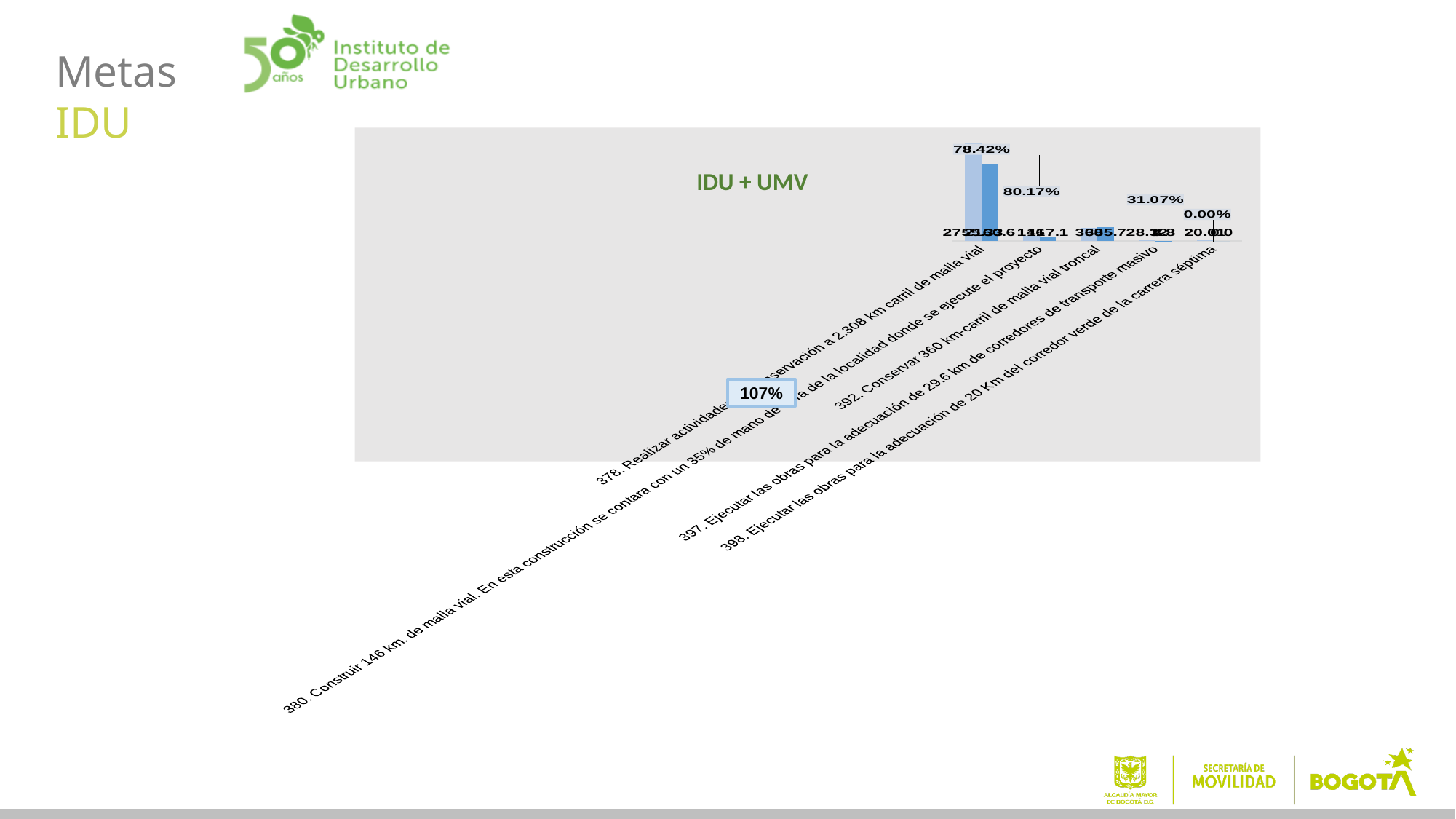
Which has the larger percentage label, meta 378 or meta 397? meta 378 What is the title of the chart on the slide? IDU + UMV What value is shown in the highlighted box placed over the chart? 107% What kind of chart is shown on the slide? combination bar and line chart Which meta has the lowest percentage label in the chart? 398. Ejecutar las obras para la adecuación de 20 Km del corredor verde de la carrera séptima What percentage is labelled above the bars for meta 378 (conservación a 2.308 km carril de malla vial)? 78.42% What is the difference between the percentage labels for meta 378 (78.42%) and meta 397 (31.07%)? 47.35 percentage points What percentage is labelled for meta 398 (adecuación de 20 Km del corredor verde de la carrera séptima)? 0.00% How many categories (metas) are shown along the x axis of the chart? 5 What percentage is labelled for meta 397 (adecuación de 29.6 km de corredores de transporte masivo)? 31.07%